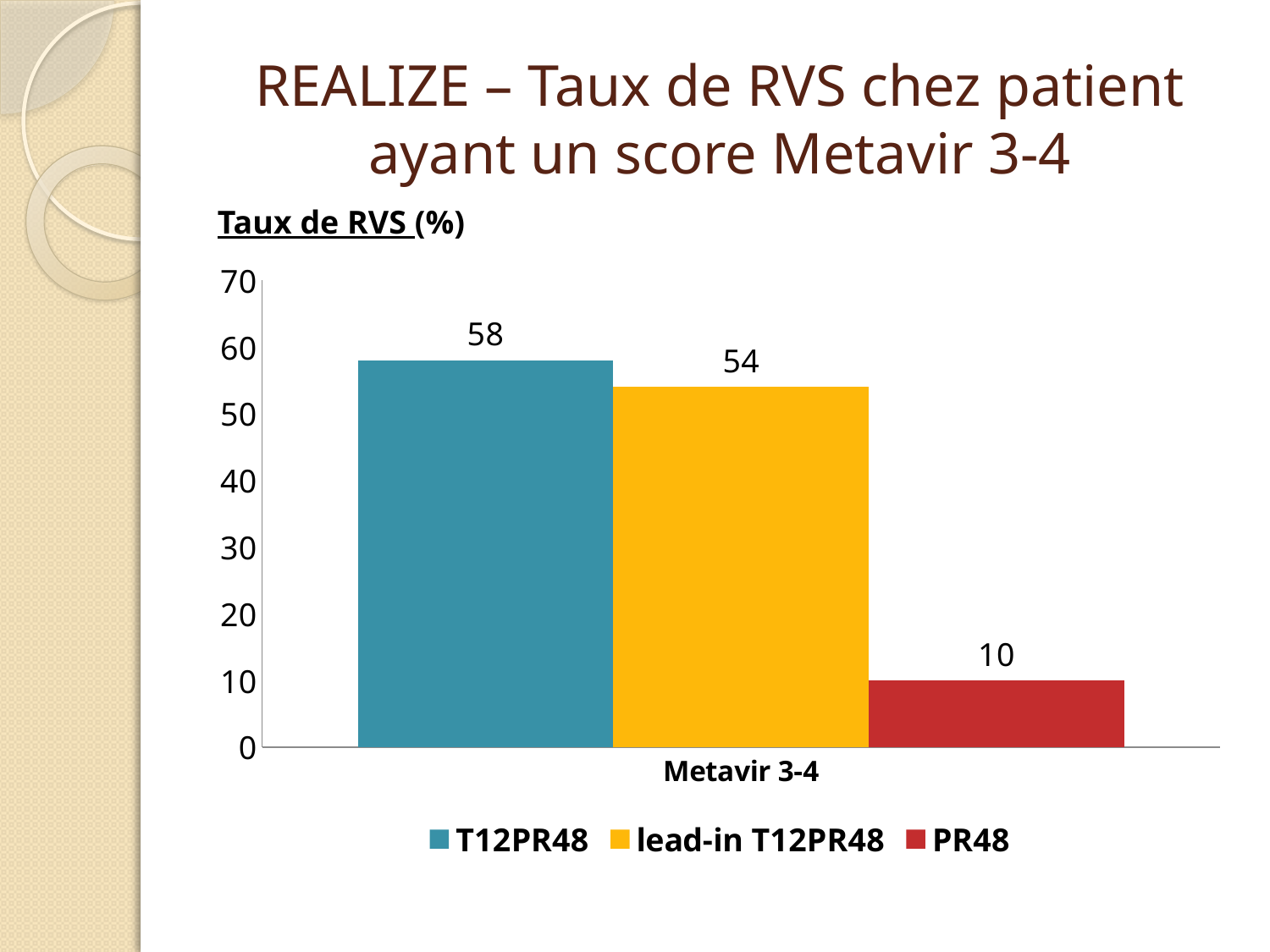
Is the value for PR48 greater or less than 20? less Which series has the lowest RVS rate? PR48 What is the difference between the RVS rates of T12PR48 and PR48? 48 Which is larger, the RVS rate for lead-in T12PR48 or for PR48? lead-in T12PR48 Which series has the highest RVS rate? T12PR48 How many series does the legend list? 3 What is the RVS rate for PR48? 10 What is the RVS rate for lead-in T12PR48? 54 What is the RVS rate for T12PR48 in the Metavir 3-4 group? 58 What is the difference between the RVS rates of T12PR48 and lead-in T12PR48? 4 What is the category label on the x axis? Metavir 3-4 What kind of chart is shown on the slide? bar chart